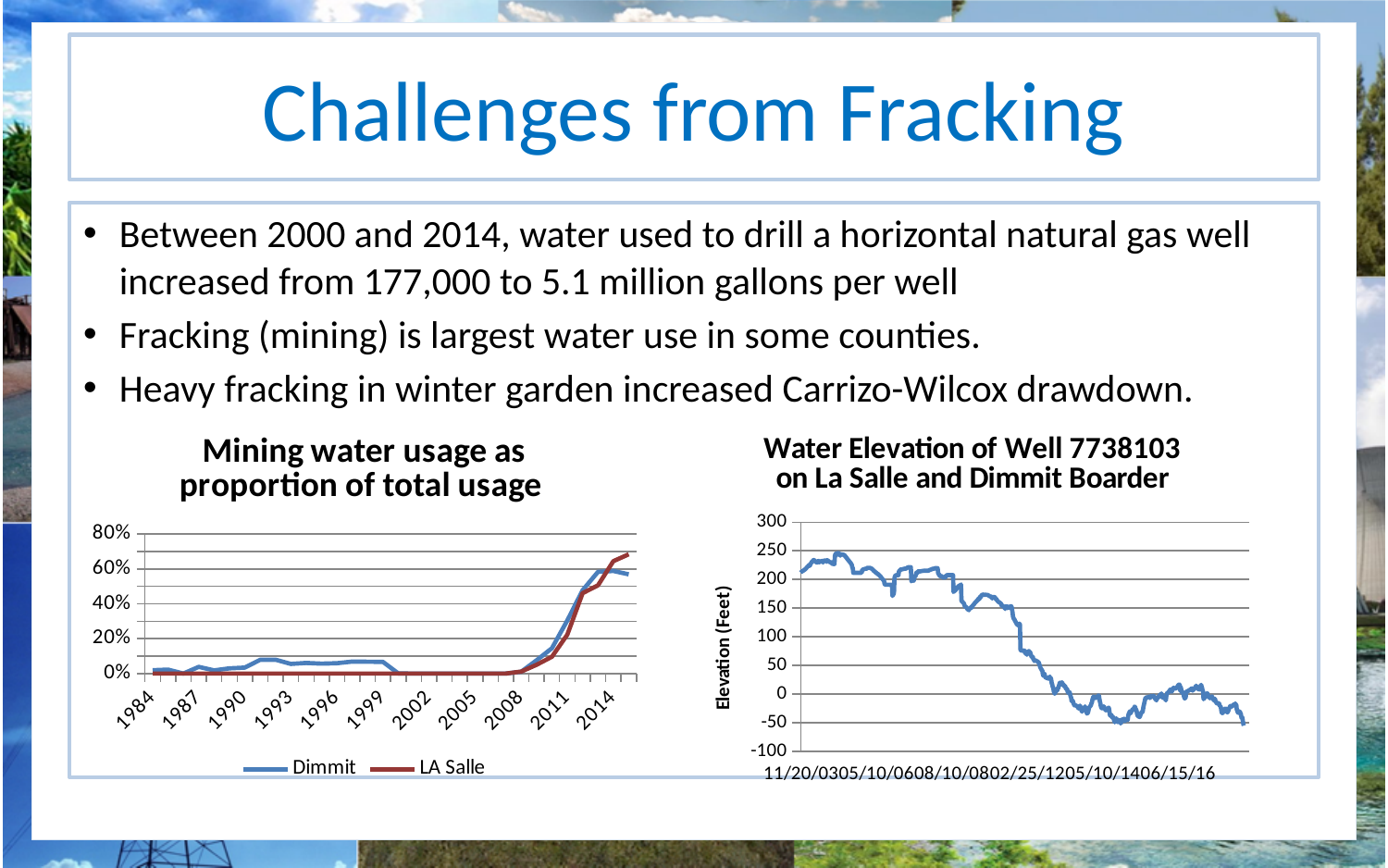
In the 'Mining water usage as proportion of total usage' chart, is the Dimmit value at 2005 greater or less than 20%? less What are the two series named in the legend of the 'Mining water usage as proportion of total usage' chart? Dimmit and LA Salle What kind of chart is the 'Water Elevation of Well 7738103 on La Salle and Dimmit Boarder' chart? line chart In the 'Water Elevation of Well 7738103 on La Salle and Dimmit Boarder' chart, is the elevation at the end of the series greater or less than 0? less In the 'Mining water usage as proportion of total usage' chart, which series has the higher value at 2014, Dimmit or LA Salle? LA Salle What kind of chart is the 'Mining water usage as proportion of total usage' chart? line chart In the 'Mining water usage as proportion of total usage' chart, is the Dimmit value at 2014 greater or less than 40%? greater In the 'Mining water usage as proportion of total usage' chart, do the values generally rise or fall from 1984 to 2014? rise What is the y-axis label of the 'Water Elevation of Well 7738103 on La Salle and Dimmit Boarder' chart? Elevation (Feet) How many series does the legend of the 'Mining water usage as proportion of total usage' chart list? 2 In the 'Water Elevation of Well 7738103 on La Salle and Dimmit Boarder' chart, does the water elevation generally rise or fall over time? fall